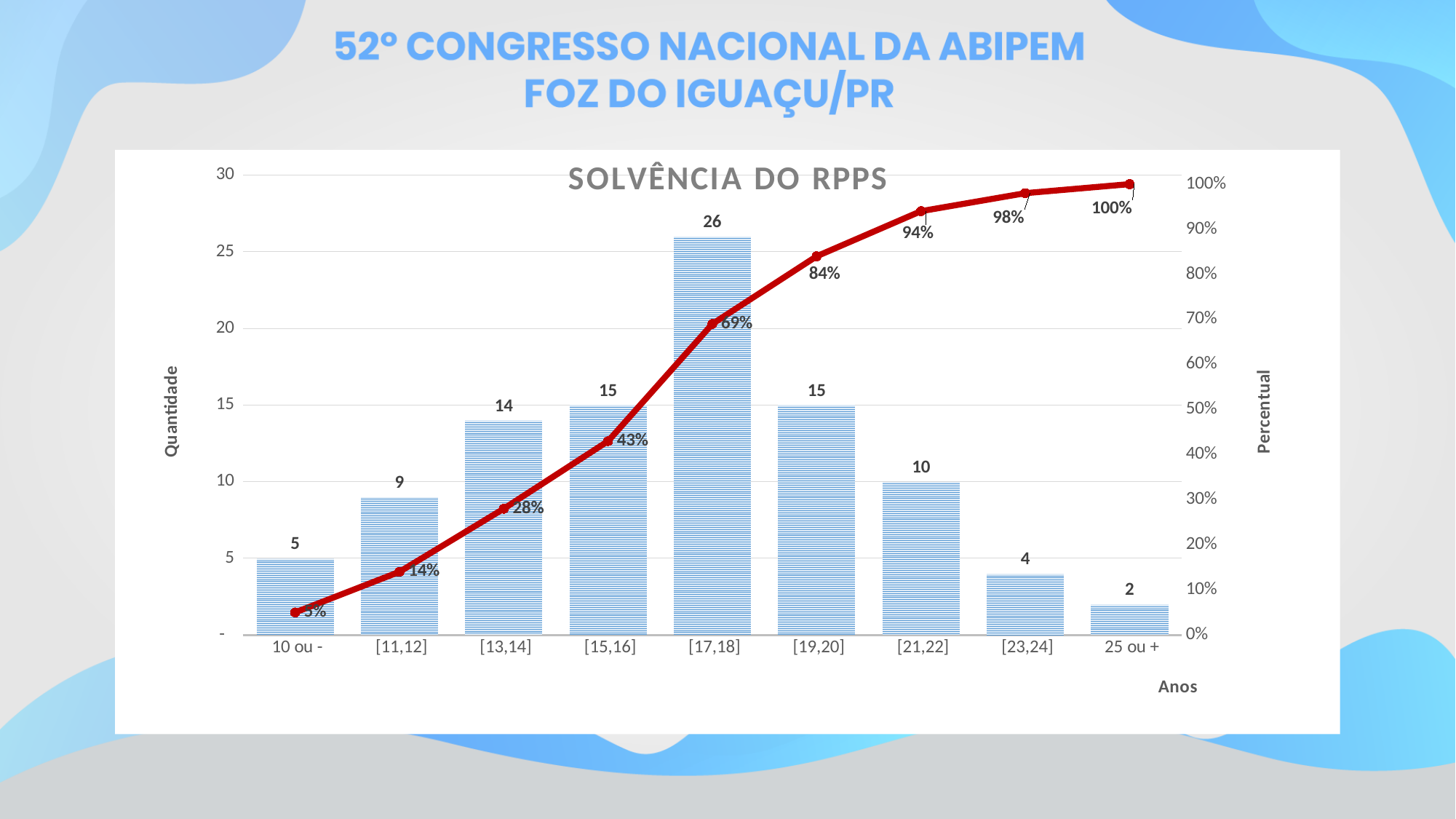
How many categories are shown on the x axis? 9 Which has a larger quantity, [11,12] or [23,24]? [11,12] What is the cumulative percentage shown for the [13,14] category? 28% What is the difference in quantity between the [17,18] and [19,20] categories? 11 What is the cumulative percentage shown for the [19,20] category? 84% Does the red percentage line rise or fall from left to right along the x axis? rise What is the label of the right-hand vertical axis? Percentual Which category has the lowest quantity? 25 ou + What is the title of the chart? SOLVÊNCIA DO RPPS What is the quantity (Quantidade) for the [17,18] category? 26 What is the quantity for the [21,22] category? 10 Which category has the highest quantity? [17,18]